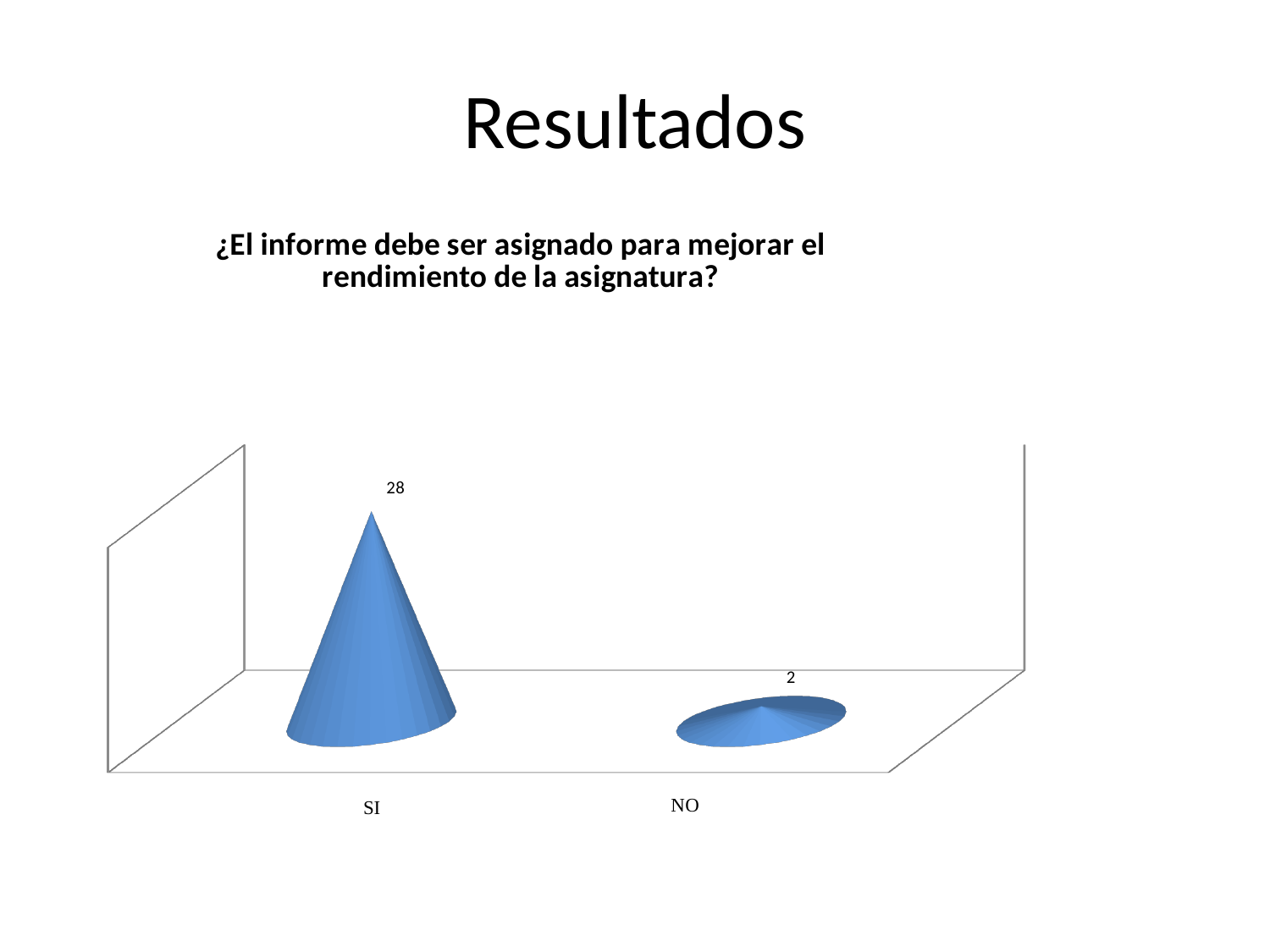
What is the total of the values for SI and NO? 30 What is the value for SI? 28 What is the title of the chart? ¿El informe debe ser asignado para mejorar el rendimiento de la asignatura? Which category has the lowest value? NO What colour are the bars in the chart? Blue What is the difference between the values for SI and NO? 26 Which category has the highest value? SI What kind of chart is shown on the slide? Bar chart What is the value for NO? 2 Which is larger, the value for SI or the value for NO? SI How many categories are shown on the chart? 2